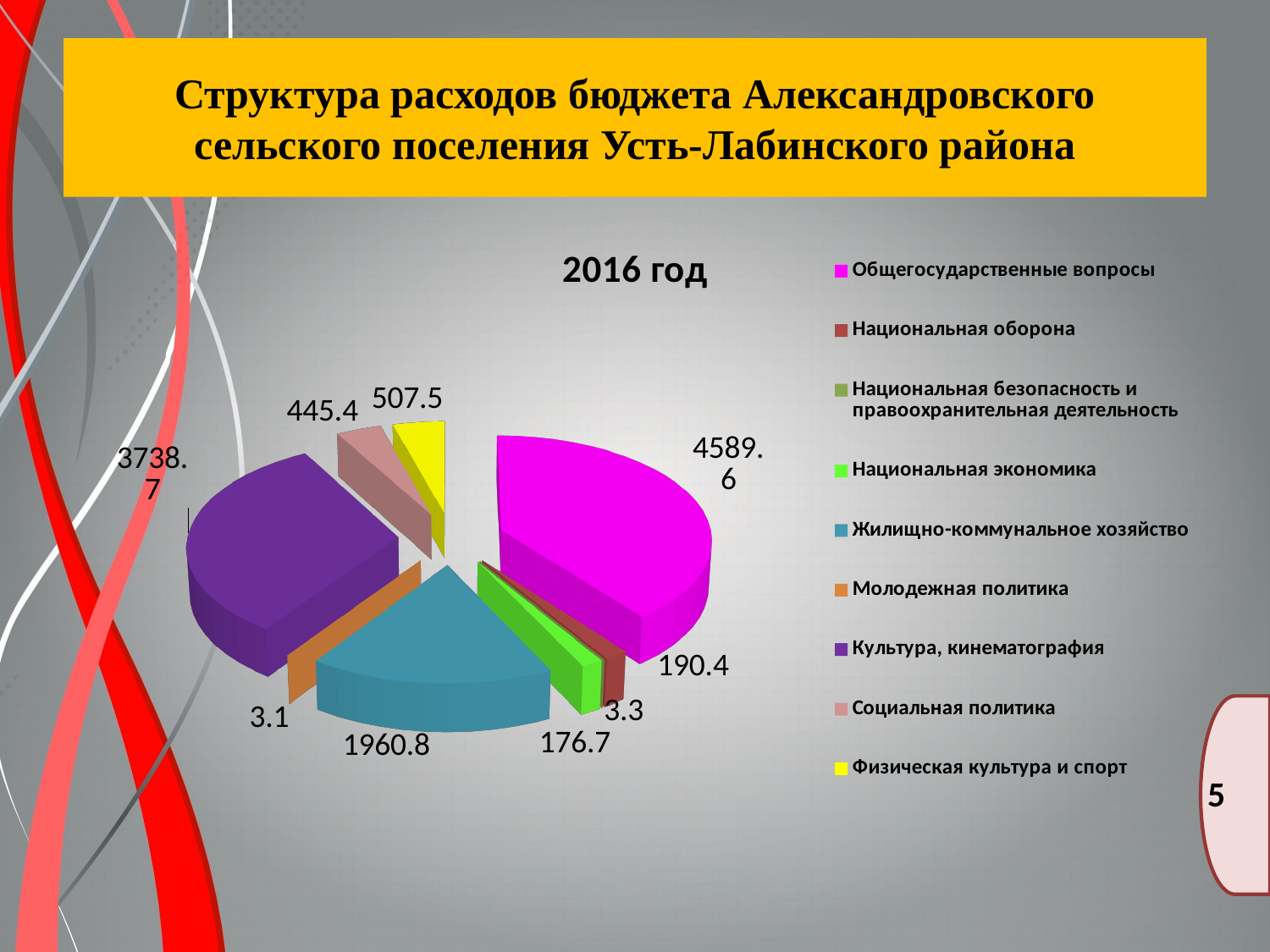
What is the value for Жилищно-коммунальное хозяйство? 1960.8 What is the title shown above the pie chart? 2016 год How many categories does the legend of the pie chart list? 9 What type of chart is shown on the slide? pie chart What is the value for Социальная политика? 445.4 Which category has the largest slice of the pie? Общегосударственные вопросы What is the value for Национальная экономика? 176.7 What is the value for Культура, кинематография? 3738.7 What is the difference between the values for Общегосударственные вопросы and Культура, кинематография? 850.9 Which is larger, the value for Социальная политика or the value for Физическая культура и спорт? Физическая культура и спорт What is the value for Физическая культура и спорт? 507.5 What is the value for Общегосударственные вопросы? 4589.6